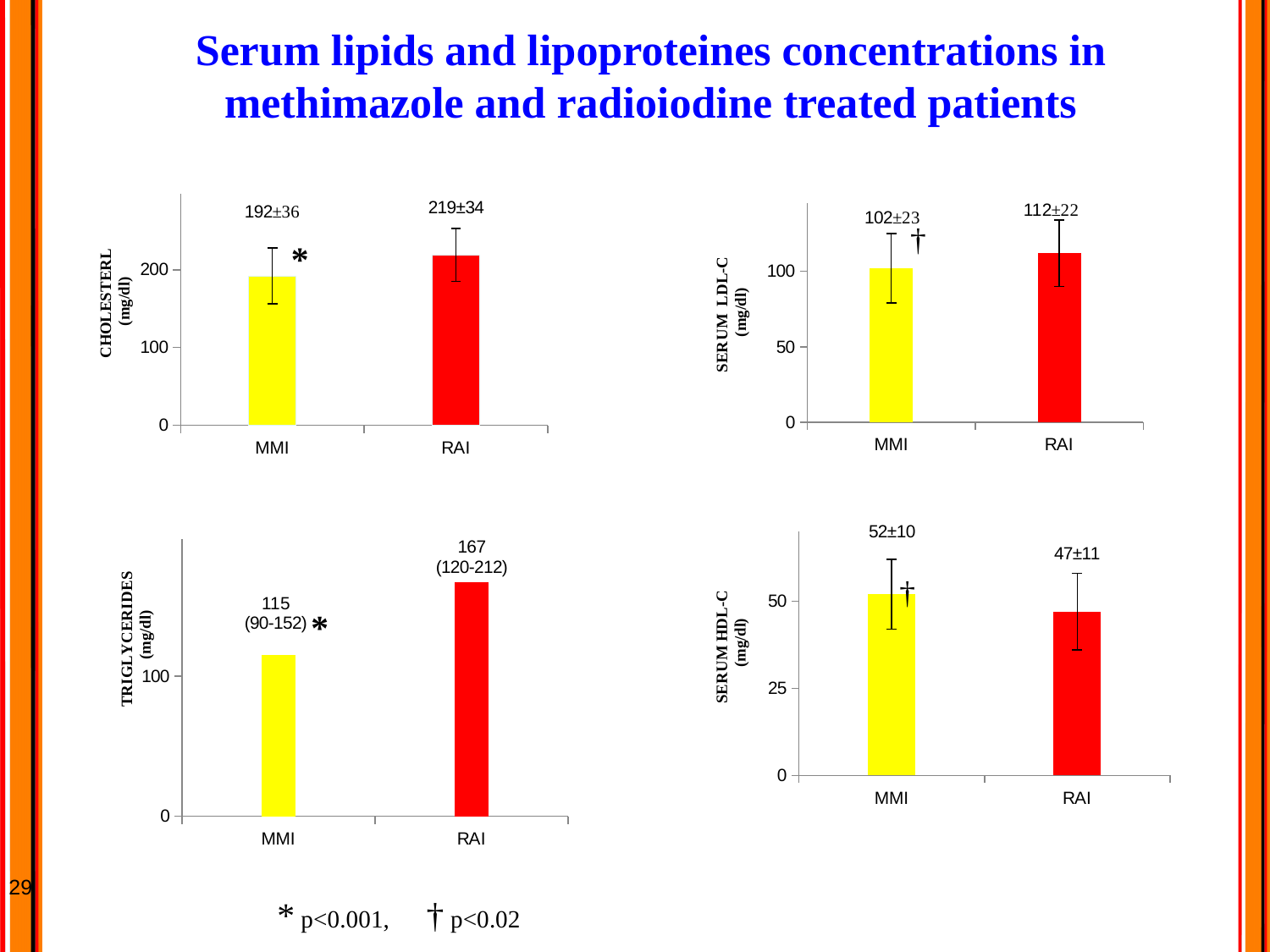
In the serum LDL-C chart (top right), what is the value labelled for the RAI bar? 112±22 In the serum HDL-C chart (bottom right), which group has the lower HDL-C value? RAI In the cholesterol chart (top left), what is the value labelled for the RAI bar? 219±34 In the triglycerides chart (bottom left), what is the difference between the RAI median (167) and the MMI median (115)? 52 In the cholesterol chart (top left), is the value for the MMI bar greater or less than 200? less In the triglycerides chart (bottom left), what is the median value labelled for the MMI bar? 115 In the serum LDL-C chart (top right), which group has the higher LDL-C value, MMI or RAI? RAI In the serum HDL-C chart (bottom right), what is the value labelled for the MMI bar? 52±10 What type of chart is used for the serum HDL-C data (bottom right)? Bar chart In the triglycerides chart (bottom left), what range is shown in parentheses for the RAI bar? (120-212) In the cholesterol chart (top left), what is the value labelled for the MMI bar? 192±36 How many charts are shown on the slide? 4